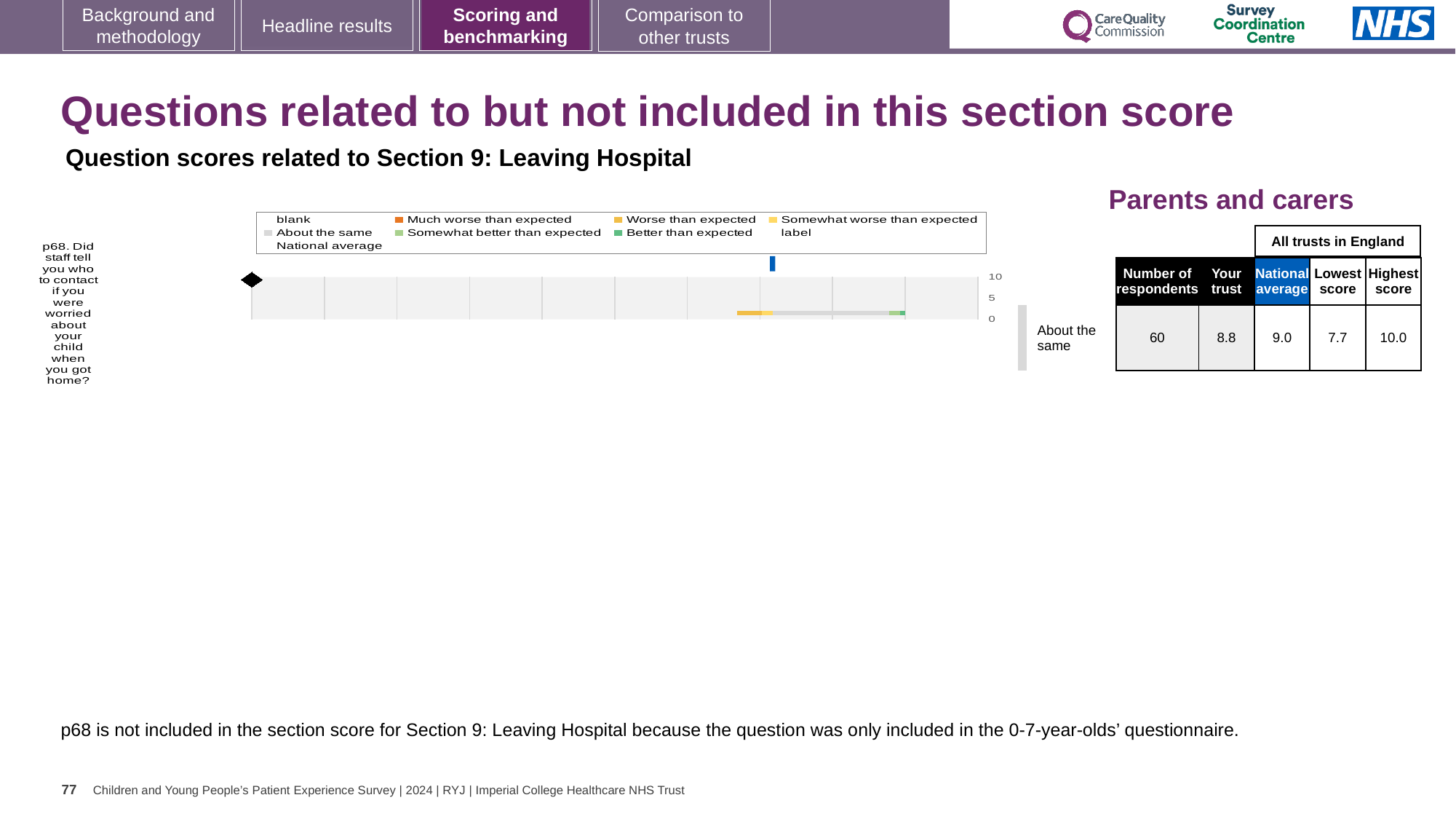
What is the national average score for question p68? 9.0 How many respondents answered question p68? 60 What is the lowest score among all trusts in England for question p68? 7.7 What is the difference between the national average and the trust's score for p68? 0.2 How many questions are plotted in the chart? 1 Is the trust's score for p68 higher or lower than the national average? lower What is the difference between the highest score and the lowest score for p68 across all trusts in England? 2.3 How is the trust's result for p68 categorised relative to expectations? About the same What is the highest score among all trusts in England for question p68? 10.0 Which respondent group does the chart and table refer to? Parents and carers What is the score for 'Your trust' for question p68? 8.8 What is the maximum value shown on the chart's score axis? 10